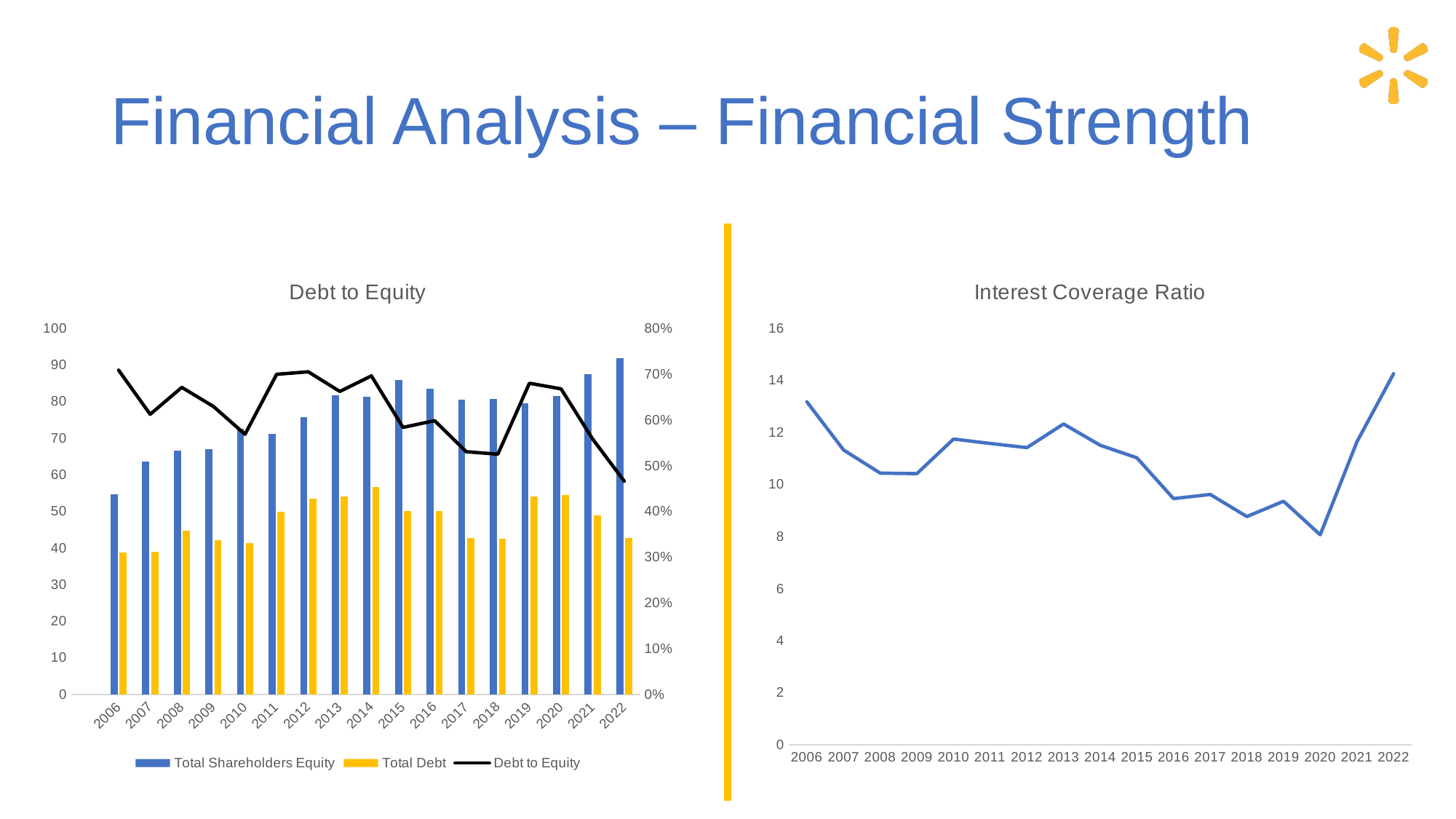
On the Debt to Equity chart, how many series does the legend list? 3 On the Interest Coverage Ratio chart, does the ratio rise or fall from 2020 to 2022? Rise On the Debt to Equity chart, is the Debt to Equity value for 2006 greater or less than 60%? greater On the Debt to Equity chart, in which year is Total Shareholders Equity highest? 2022 On the Interest Coverage Ratio chart, in which year is the ratio lowest? 2020 On the Interest Coverage Ratio chart, in which year is the ratio highest? 2022 On the Debt to Equity chart, which is larger in 2010: Total Shareholders Equity or Total Debt? Total Shareholders Equity On the Debt to Equity chart, is the Total Shareholders Equity value for 2022 greater or less than 80? greater On the Debt to Equity chart, in which year is the Debt to Equity line at its lowest? 2022 What type of chart is the Interest Coverage Ratio chart? Line chart On the Interest Coverage Ratio chart, is the value for 2020 greater or less than 10? less On the Debt to Equity chart, how many years are shown on the x axis? 17